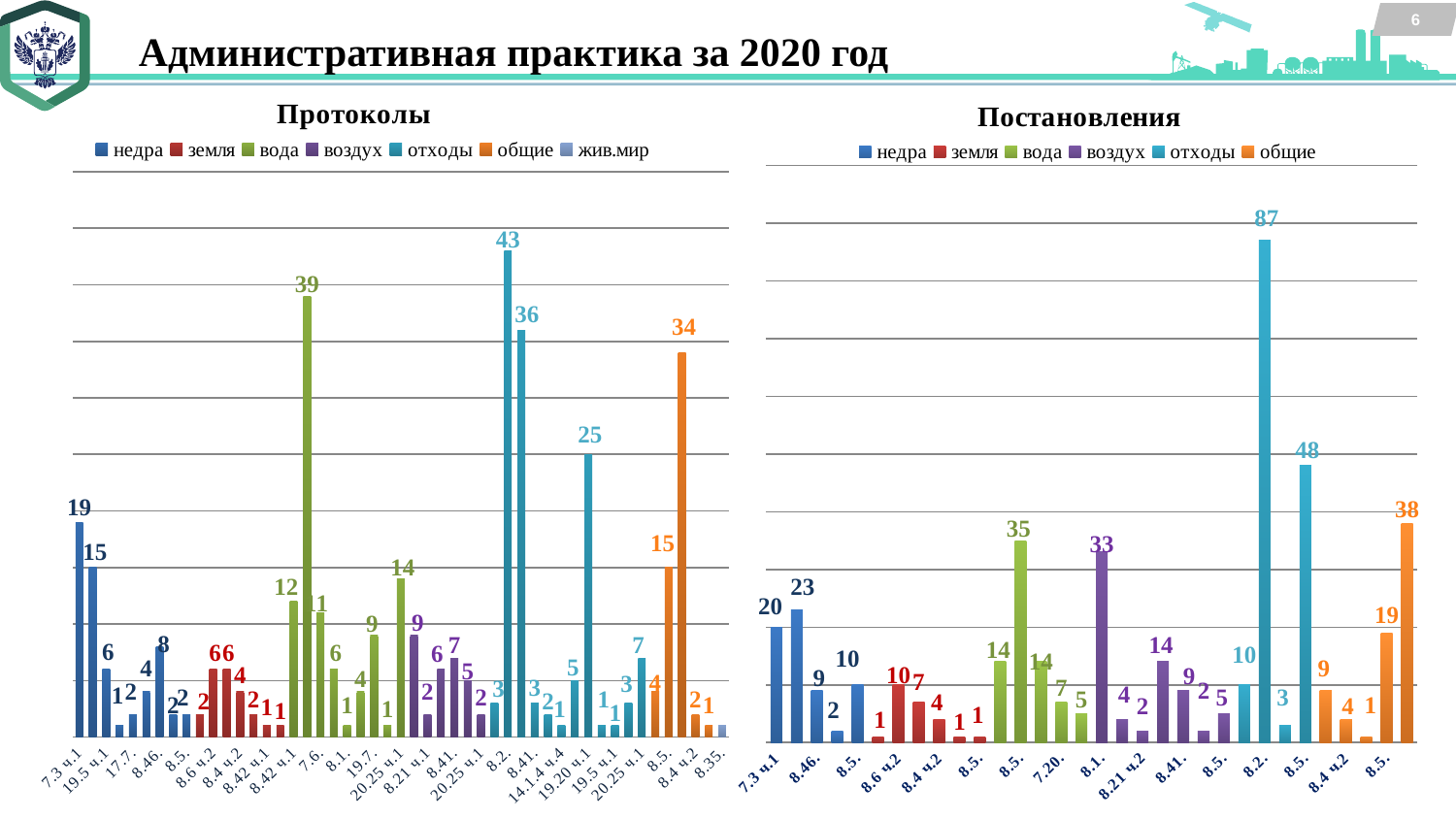
In the Постановления chart, what is the highest value shown? 87 In the Протоколы chart, what is the value of the tallest общие (orange) bar? 34 Which legend entry appears in the Протоколы chart but not in the Постановления chart? жив.мир In the Протоколы chart, what is the highest value shown? 43 In the Постановления chart, what is the value of the tallest вода (green) bar? 35 What kind of chart is the Протоколы chart on the left? bar chart In the Протоколы chart, what is the value of the tallest вода (green) bar? 39 Which is larger: the highest value in the Постановления chart or the highest value in the Протоколы chart? Постановления (87) In the Постановления chart, what is the difference between the two tallest отходы bars (87 and 48)? 39 In the Постановления chart, what is the value of the tallest общие (orange) bar? 38 How many series does the legend of the Протоколы chart list? 7 How many series does the legend of the Постановления chart list? 6